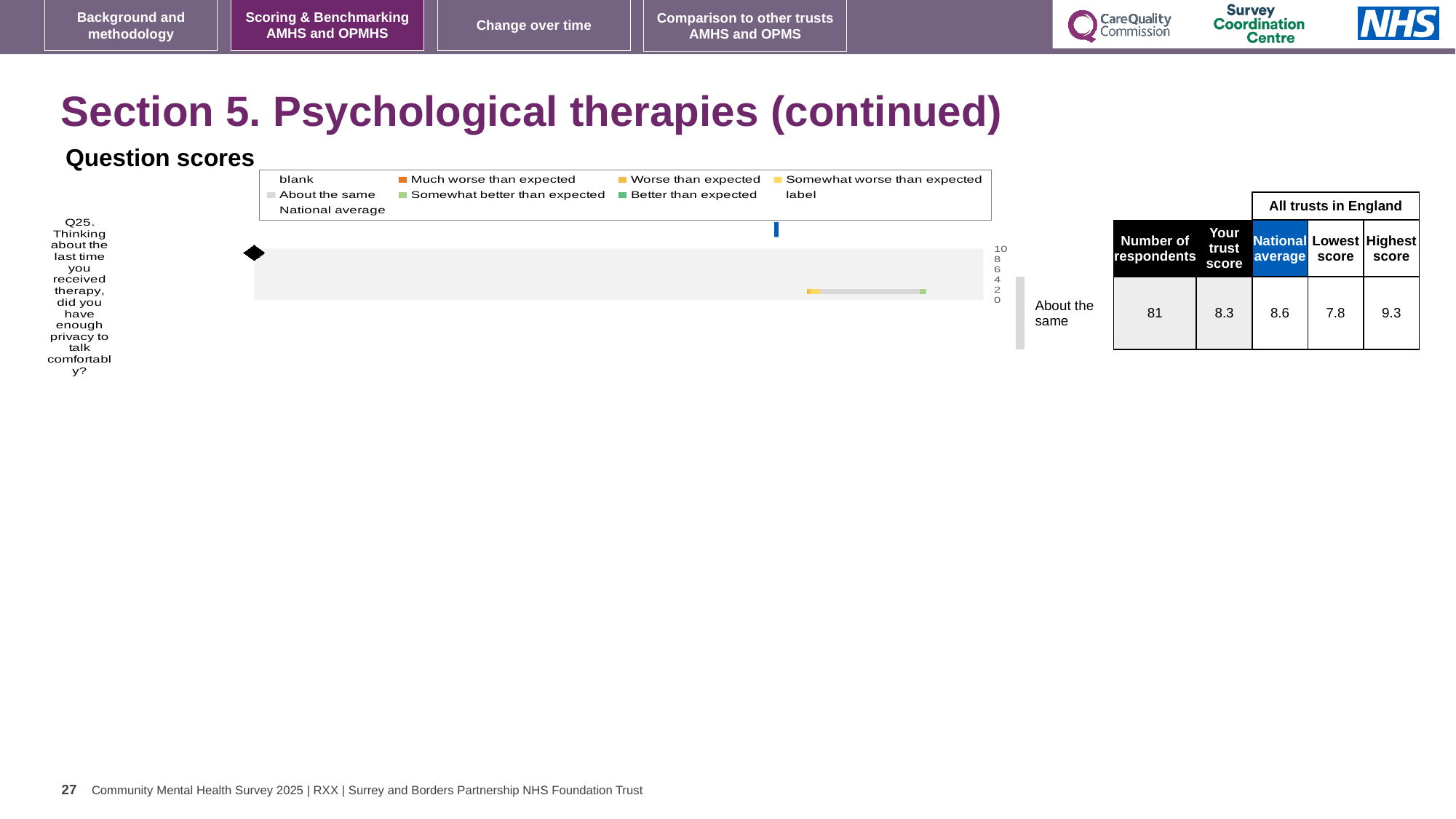
Which is larger for Q25: the trust score or the national average? national average In the table beside the chart, what is the number of respondents for Q25? 81 In the table beside the chart, what is the lowest score among all trusts in England for Q25? 7.8 What is the highest value shown on the chart's score axis? 10 How many survey questions are plotted in the chart? 1 Which question number is plotted in the chart? Q25 What kind of chart is shown under 'Question scores'? bar chart In the table beside the chart, what is 'Your trust score' for Q25? 8.3 What is the difference between the highest score (9.3) and the lowest score (7.8) for Q25? 1.5 In the table beside the chart, what is the national average for Q25? 8.6 What benchmark category label is shown next to the chart for Q25? About the same In the table beside the chart, what is the highest score among all trusts in England for Q25? 9.3